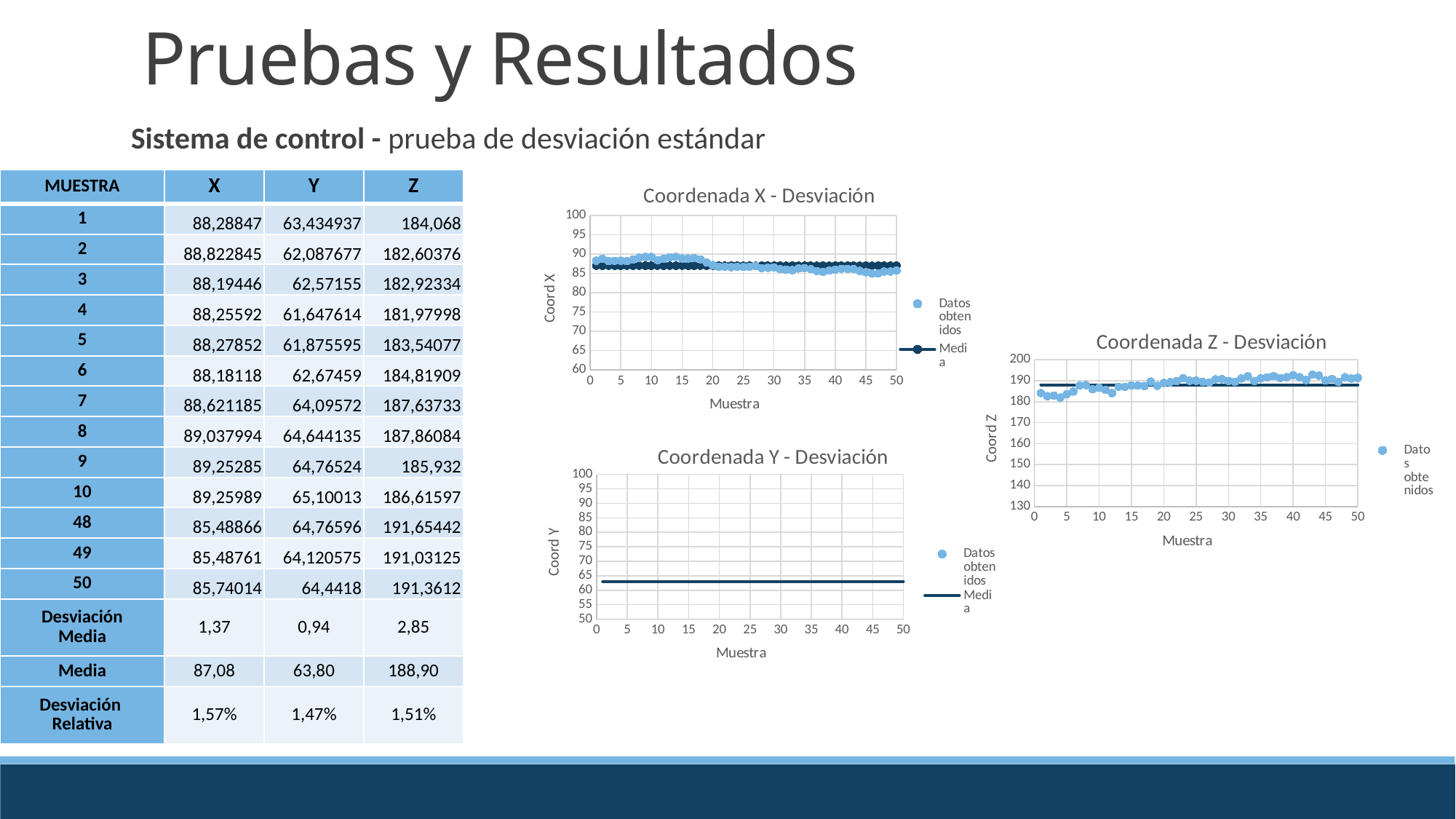
In the 'Coordenada X - Desviación' chart, is the value for sample 10 greater or less than 80? greater What is the y-axis label of the 'Coordenada Z - Desviación' chart? Coord Z In the 'Coordenada Z - Desviación' chart, do the 'Datos obtenidos' values generally rise or fall as the sample number increases? rise What is the x-axis label of the 'Coordenada Y - Desviación' chart? Muestra In the 'Coordenada X - Desviación' chart, do the 'Datos obtenidos' values generally rise or fall from sample 1 to sample 50? fall In the 'Coordenada X - Desviación' chart, is the value for sample 50 greater or less than 95? less In the 'Coordenada Y - Desviación' chart, is the 'Media' line greater or less than 70? less How many series does the legend of the 'Coordenada X - Desviación' chart list? 2 What kind of chart is the 'Coordenada X - Desviación' chart? scatter chart How many series does the legend of the 'Coordenada Z - Desviación' chart list? 1